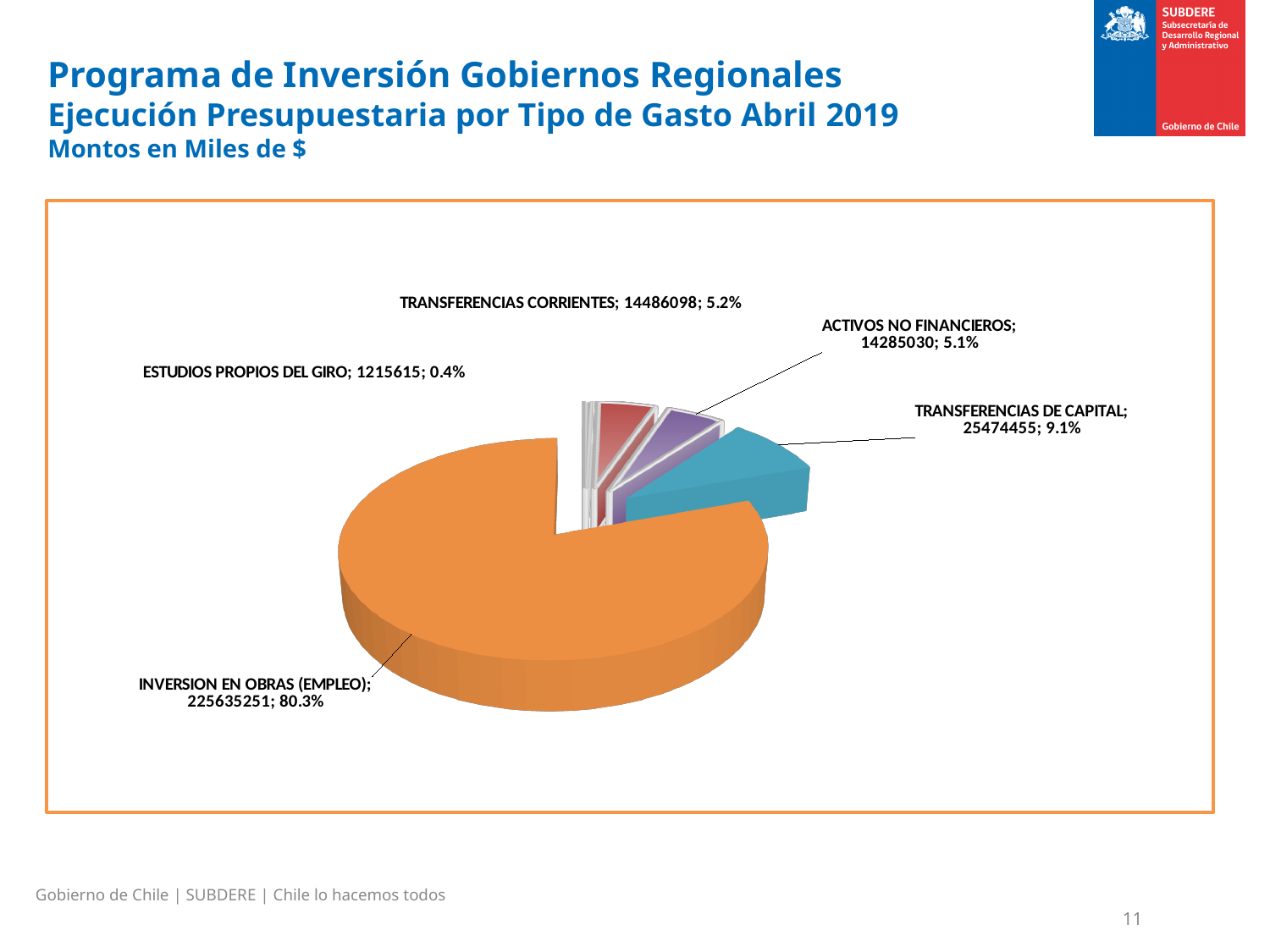
What kind of chart is shown on the slide? pie chart What is the value for INVERSION EN OBRAS (EMPLEO)? 225635251 What percentage share does TRANSFERENCIAS DE CAPITAL have? 9.1% Which category has the largest slice of the pie? INVERSION EN OBRAS (EMPLEO) What percentage share does ESTUDIOS PROPIOS DEL GIRO have? 0.4% How many slices does the pie chart have? 5 What is the percentage share of TRANSFERENCIAS CORRIENTES? 5.2% What is the value for ACTIVOS NO FINANCIEROS? 14285030 Which is larger, the value for TRANSFERENCIAS DE CAPITAL or the value for ACTIVOS NO FINANCIEROS? TRANSFERENCIAS DE CAPITAL What is the difference between the values for TRANSFERENCIAS DE CAPITAL and TRANSFERENCIAS CORRIENTES? 10988357 In what units are the amounts in the chart expressed, according to the slide subtitle? Miles de $ Which category has the smallest slice of the pie? ESTUDIOS PROPIOS DEL GIRO